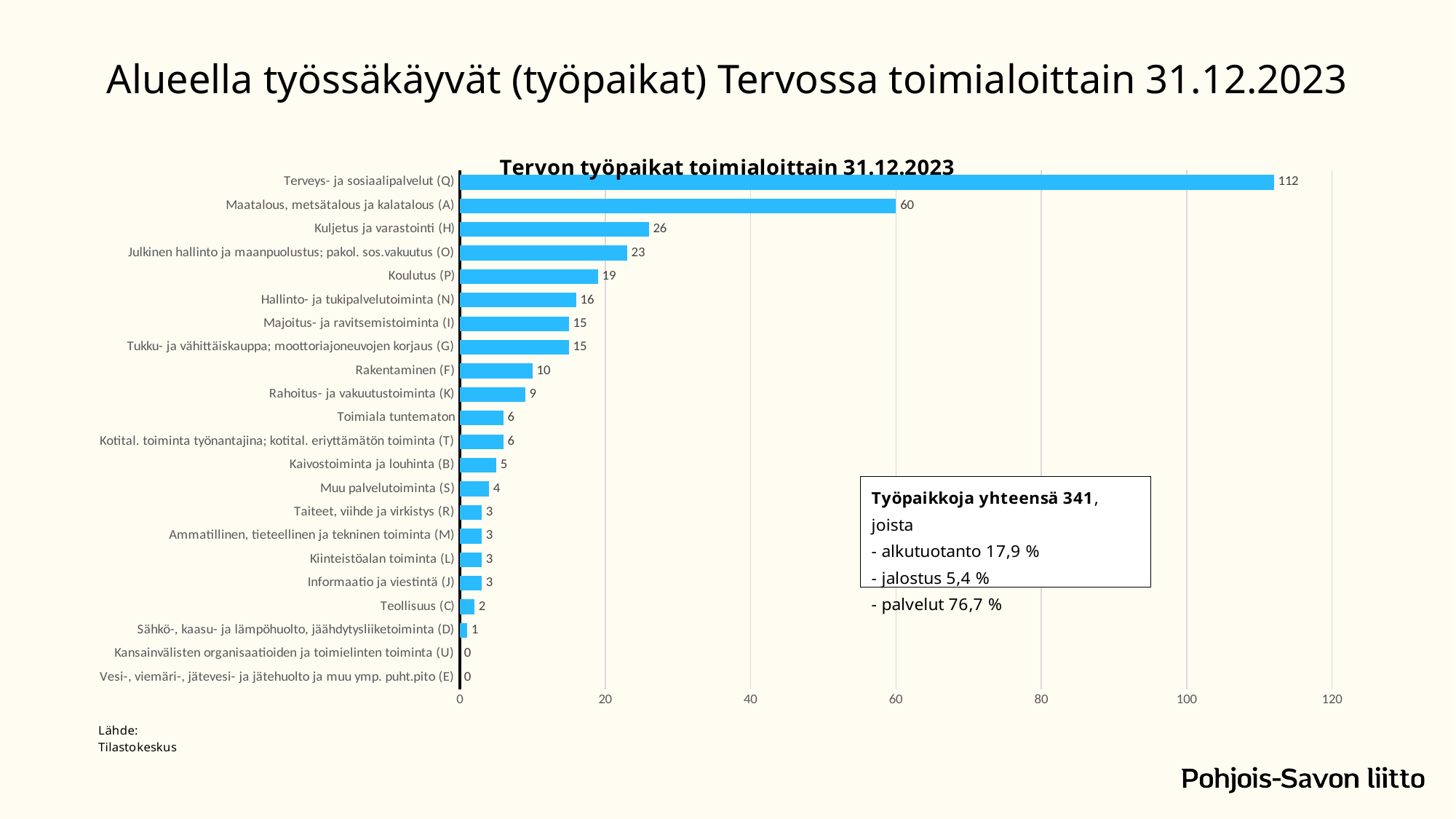
How many categories are shown in the chart? 22 Which category has the highest value? Terveys- ja sosiaalipalvelut (Q) What is the value for Kuljetus ja varastointi (H)? 26 What is the value for Koulutus (P)? 19 Which is larger, Hallinto- ja tukipalvelutoiminta (N) or Rahoitus- ja vakuutustoiminta (K)? Hallinto- ja tukipalvelutoiminta (N) What is the value for Rakentaminen (F)? 10 What kind of chart is shown on the slide? Bar chart What is the value for Terveys- ja sosiaalipalvelut (Q)? 112 What is the difference between Terveys- ja sosiaalipalvelut (Q) and Maatalous, metsätalous ja kalatalous (A)? 52 Is the value for Maatalous, metsätalous ja kalatalous (A) greater or less than 40? greater What is the difference between Kuljetus ja varastointi (H) and Julkinen hallinto ja maanpuolustus; pakol. sos.vakuutus (O)? 3 What is the title of the chart? Tervon työpaikat toimialoittain 31.12.2023